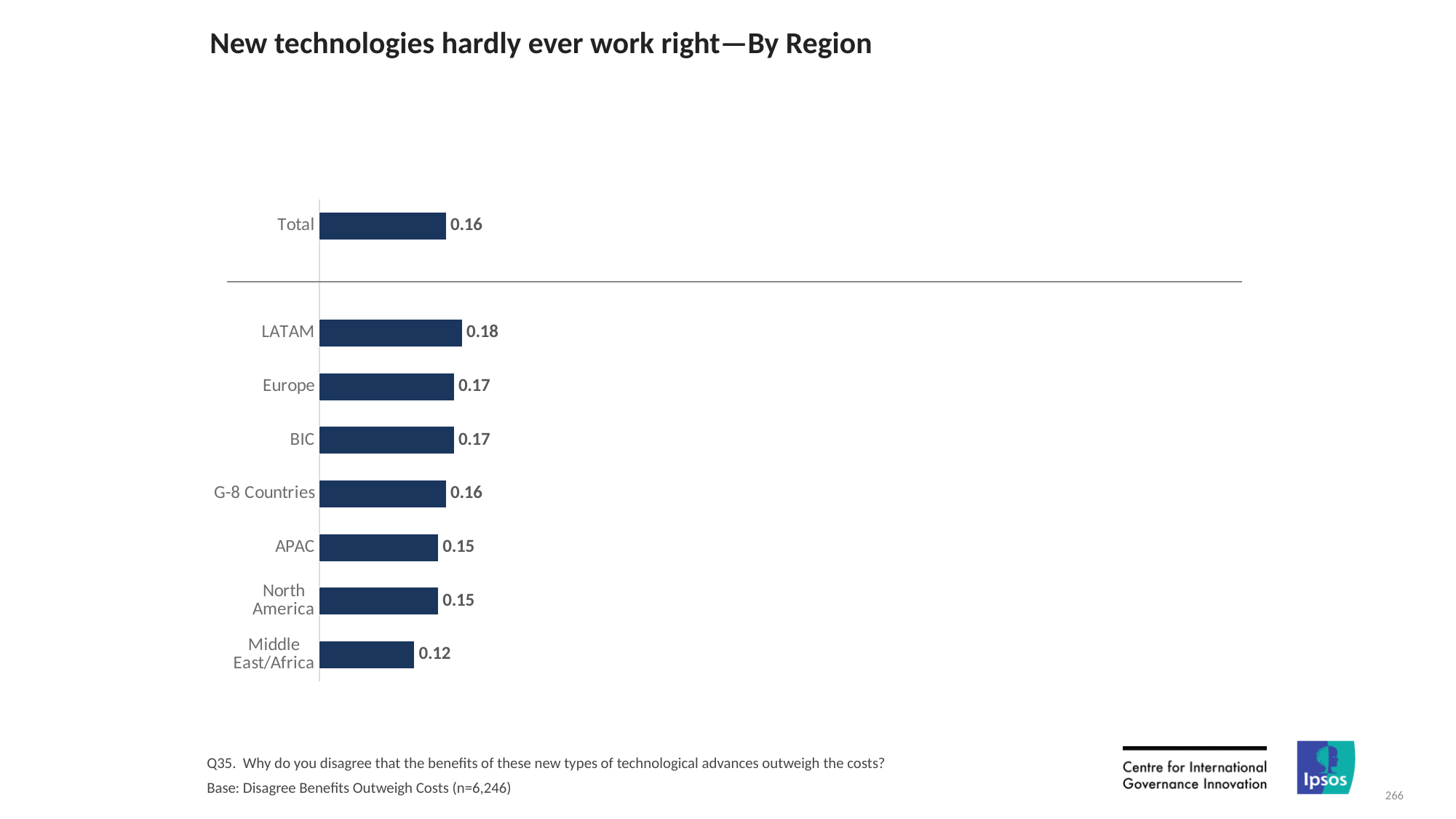
What kind of chart is shown on the slide? Bar chart Which region has the lowest value? Middle East/Africa How many bars are shown in the chart, including Total? 8 What is the difference between the values for Europe and APAC? 0.02 What is the difference between the values for LATAM and Middle East/Africa? 0.06 What is the value for LATAM? 0.18 What is the value for Total? 0.16 What is the title of the chart? New technologies hardly ever work right—By Region What is the value for North America? 0.15 Which region has the highest value? LATAM Which is larger, the value for G-8 Countries or the value for Middle East/Africa? G-8 Countries What is the value for Middle East/Africa? 0.12